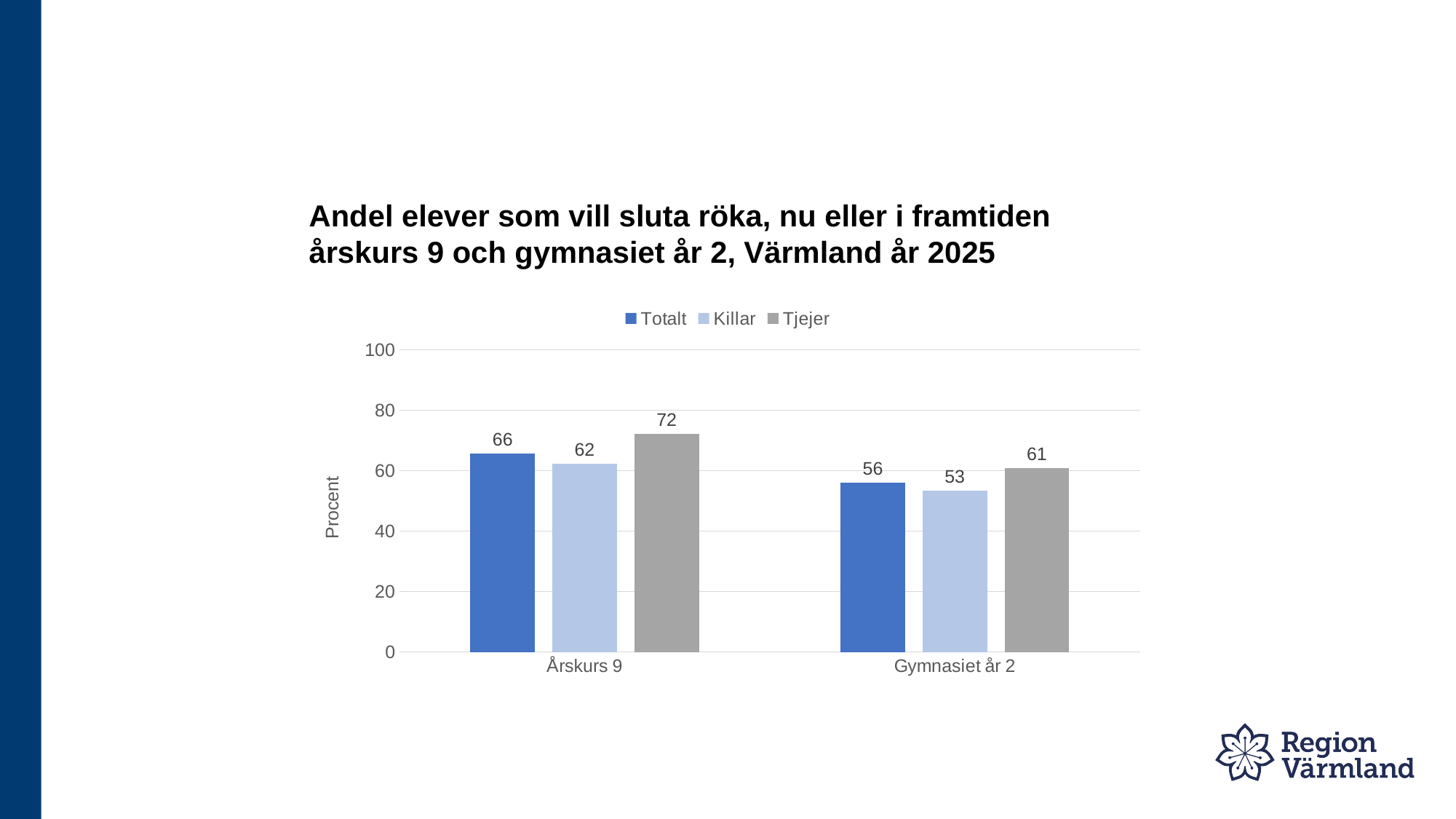
What kind of chart is shown on the slide? bar chart What is the Totalt value for Gymnasiet år 2? 56 Which series has the highest value in Årskurs 9? Tjejer How many series does the legend list? 3 What is the value for Killar in Gymnasiet år 2? 53 What is the difference between Tjejer and Killar in Årskurs 9? 10 Which is larger: Totalt for Årskurs 9 or Totalt for Gymnasiet år 2? Totalt for Årskurs 9 What is the label of the vertical axis? Procent Is the value for Killar in Gymnasiet år 2 greater or less than 60? less Which series has the lowest value in Gymnasiet år 2? Killar What is the value for Tjejer in Årskurs 9? 72 What is the difference between the Tjejer values for Årskurs 9 and Gymnasiet år 2? 11